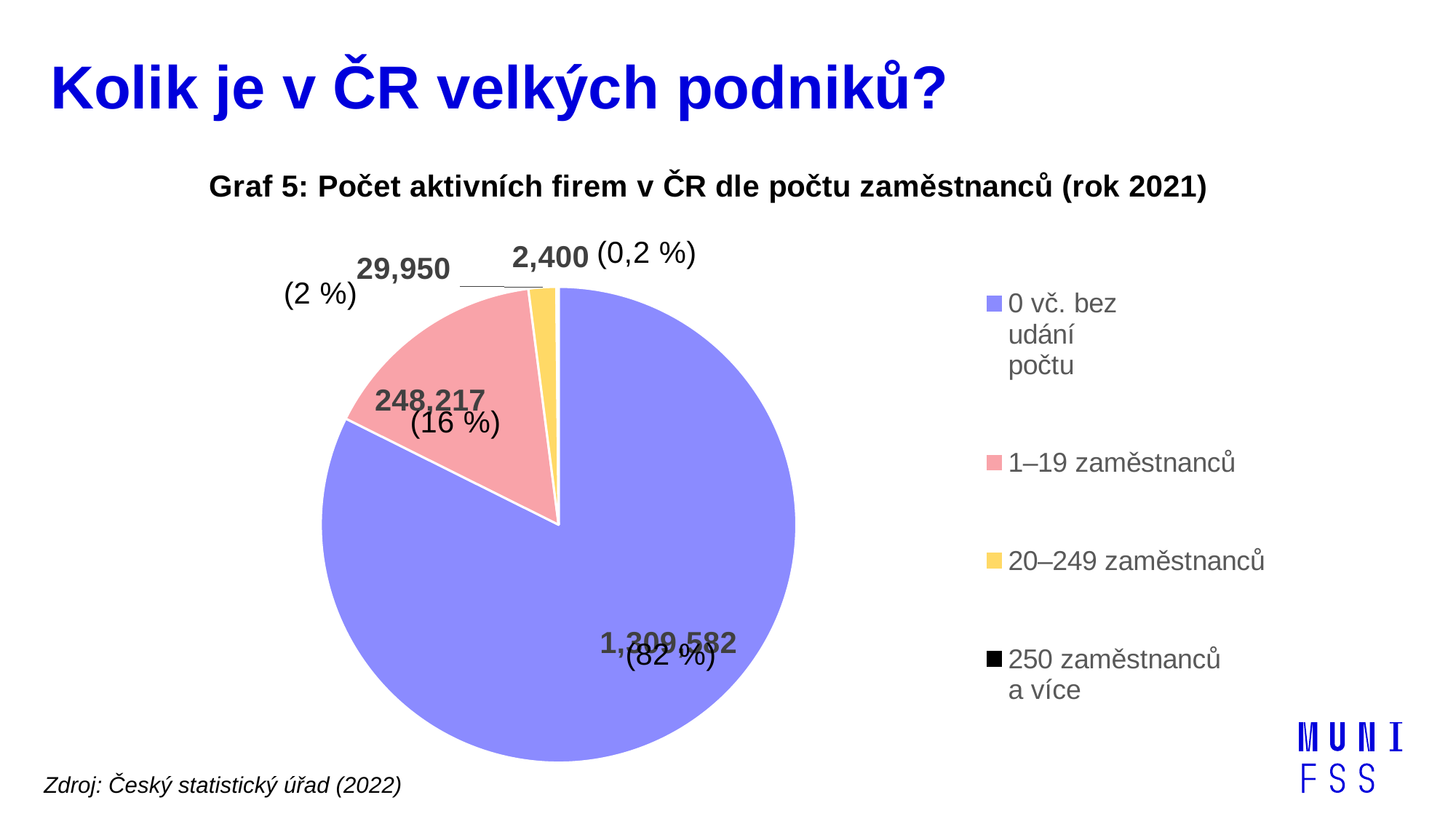
Which category has the largest slice of the pie? 0 vč. bez udání počtu What is the number of firms with 20–249 zaměstnanců? 29,950 What is the difference between the number of firms with 20–249 zaměstnanců and the number with 250 zaměstnanců a více? 27,550 What share of the pie does the '0 vč. bez udání počtu' slice represent? 82 % What type of chart is shown on the slide? pie chart What is the number of firms with 250 zaměstnanců a více? 2,400 Which is larger: the slice for '1–19 zaměstnanců' or the slice for '20–249 zaměstnanců'? 1–19 zaměstnanců Which category has the smallest slice of the pie? 250 zaměstnanců a více How many categories does the legend of the pie chart list? 4 What share of the pie does the '250 zaměstnanců a více' slice represent? 0,2 % What share of the pie does the '1–19 zaměstnanců' slice represent? 16 %